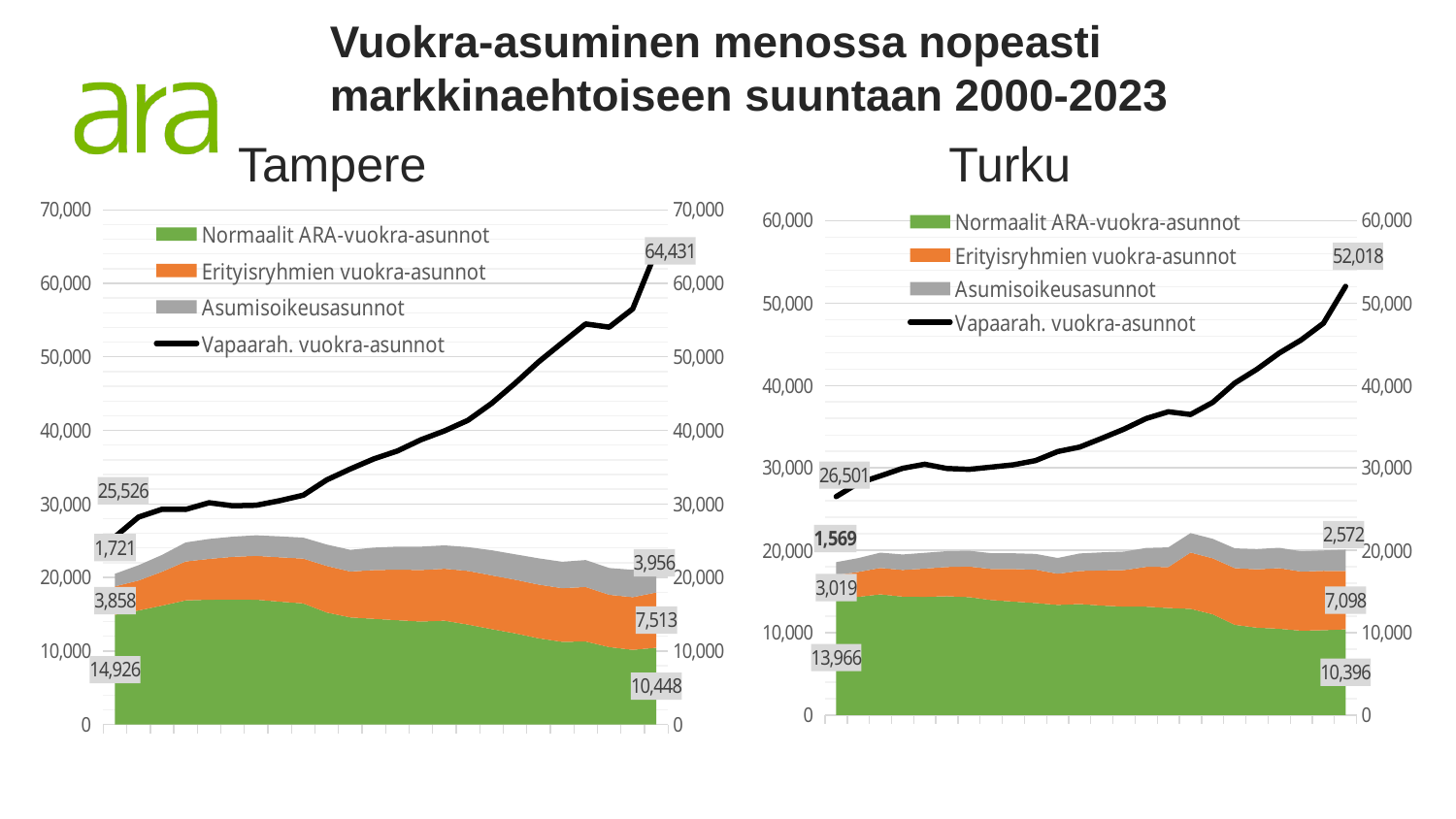
Which city has the higher final value of Vapaarah. vuokra-asunnot, Tampere or Turku? Tampere In the Turku chart, by how much did Normaalit ARA-vuokra-asunnot decrease from its first labelled value to its last? 3,570 In the Turku chart, which series is drawn as a black line? Vapaarah. vuokra-asunnot In the Turku chart, what is the starting labelled value of Asumisoikeusasunnot? 1,569 In the Turku chart, what is the final labelled value of Vapaarah. vuokra-asunnot? 52,018 In the Tampere chart, by how much did Vapaarah. vuokra-asunnot increase from its first labelled value to its last? 38,905 In the Turku chart, does the Normaalit ARA-vuokra-asunnot area rise or fall over the period? fall In the Tampere chart, what is the starting labelled value of Normaalit ARA-vuokra-asunnot? 14,926 In the Tampere chart, what is the final labelled value of Vapaarah. vuokra-asunnot? 64,431 In the Tampere chart, does the Vapaarah. vuokra-asunnot line rise or fall over the period? rise How many series does the legend of the Tampere chart list? 4 In the Turku chart, what is the final labelled value of Erityisryhmien vuokra-asunnot? 7,098